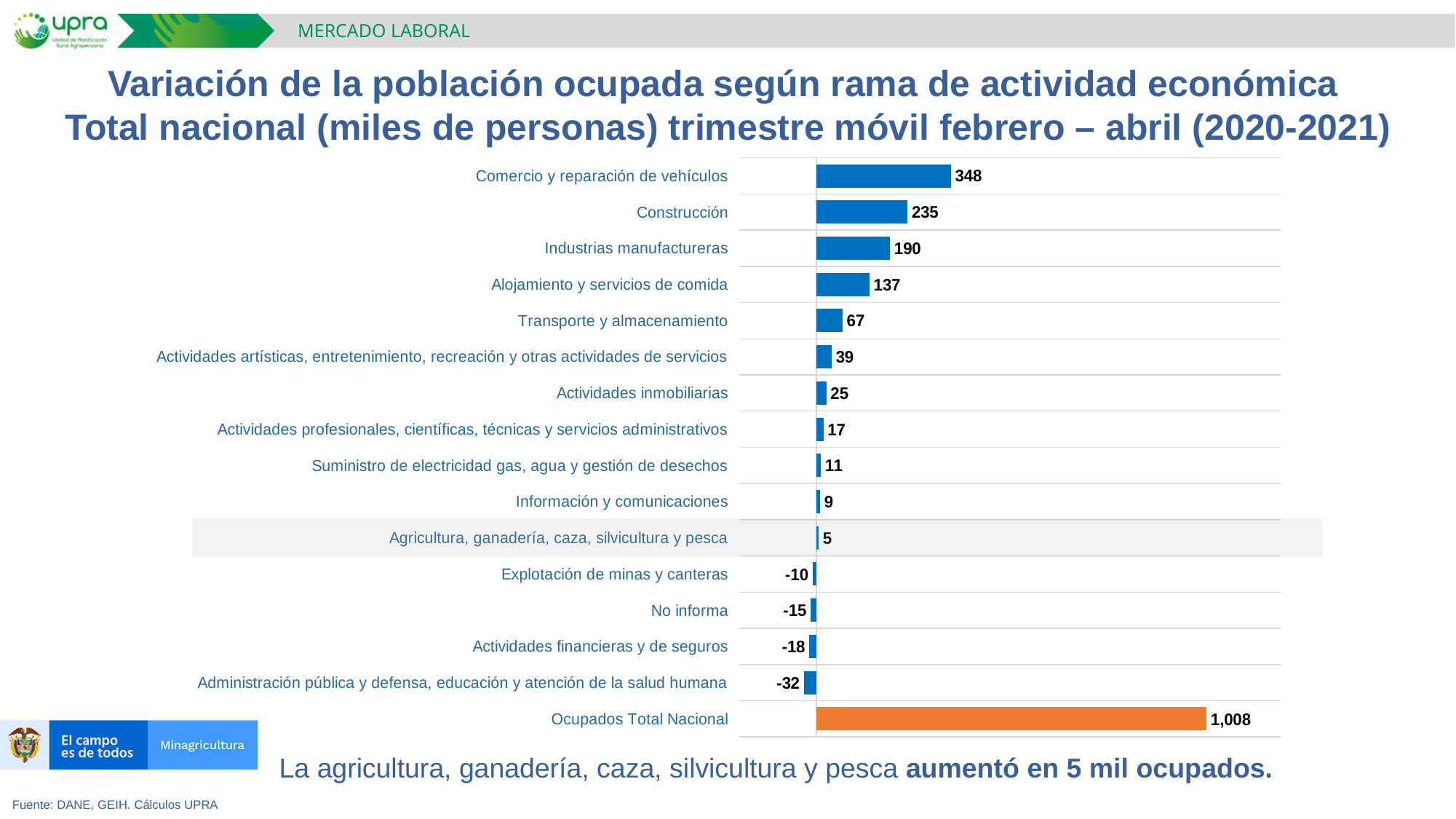
What kind of chart is shown on the slide? Bar chart Which category has the lowest value? Administración pública y defensa, educación y atención de la salud humana Which bar is drawn in orange rather than blue? Ocupados Total Nacional How many categories have a negative value? 4 What is the value for Agricultura, ganadería, caza, silvicultura y pesca? 5 What is the difference between the values for Comercio y reparación de vehículos and Construcción? 113 What is the value for Administración pública y defensa, educación y atención de la salud humana? -32 What is the value for Comercio y reparación de vehículos? 348 Which is larger, the value for Industrias manufactureras or the value for Alojamiento y servicios de comida? Industrias manufactureras What is the value for Ocupados Total Nacional? 1,008 Excluding the Ocupados Total Nacional bar, which category has the highest value? Comercio y reparación de vehículos How many categories (bars) are shown in the chart? 16